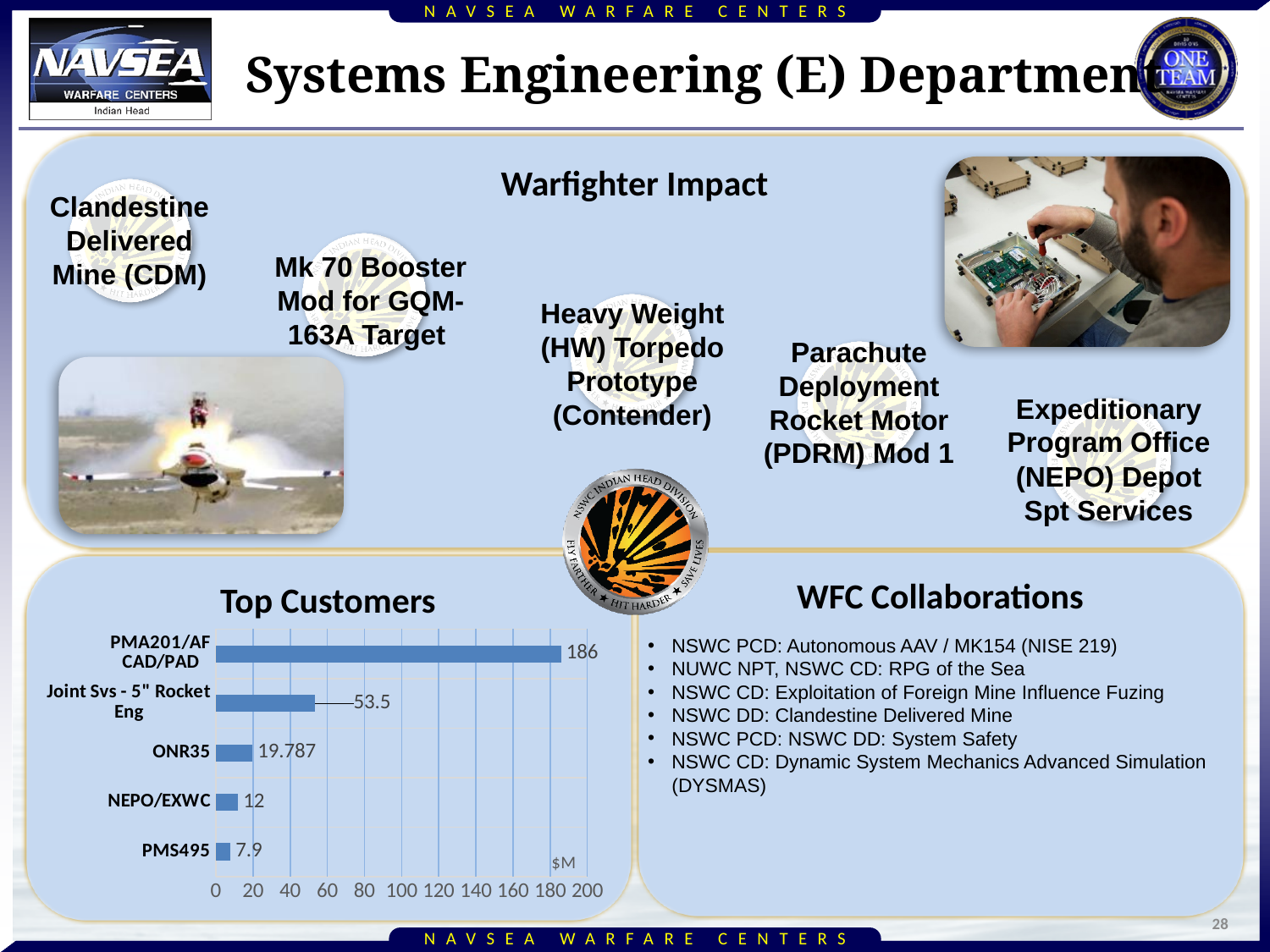
What is the value for Joint Svs - 5" Rocket Eng in the Top Customers chart? 53.5 Which customer has the lowest value in the Top Customers chart? PMS495 In the Top Customers chart, what is the difference between the values for PMA201/AF CAD/PAD and Joint Svs - 5" Rocket Eng? 132.5 Which customer has the highest value in the Top Customers chart? PMA201/AF CAD/PAD In the Top Customers chart, which is larger: the value for ONR35 or the value for NEPO/EXWC? ONR35 What is the value for PMA201/AF CAD/PAD in the Top Customers chart? 186 How many customers are shown in the Top Customers chart? 5 What is the value for ONR35 in the Top Customers chart? 19.787 What kind of chart is the Top Customers chart? Bar chart What is the value for NEPO/EXWC in the Top Customers chart? 12 What is the value for PMS495 in the Top Customers chart? 7.9 What unit is shown on the x axis of the Top Customers chart? $M